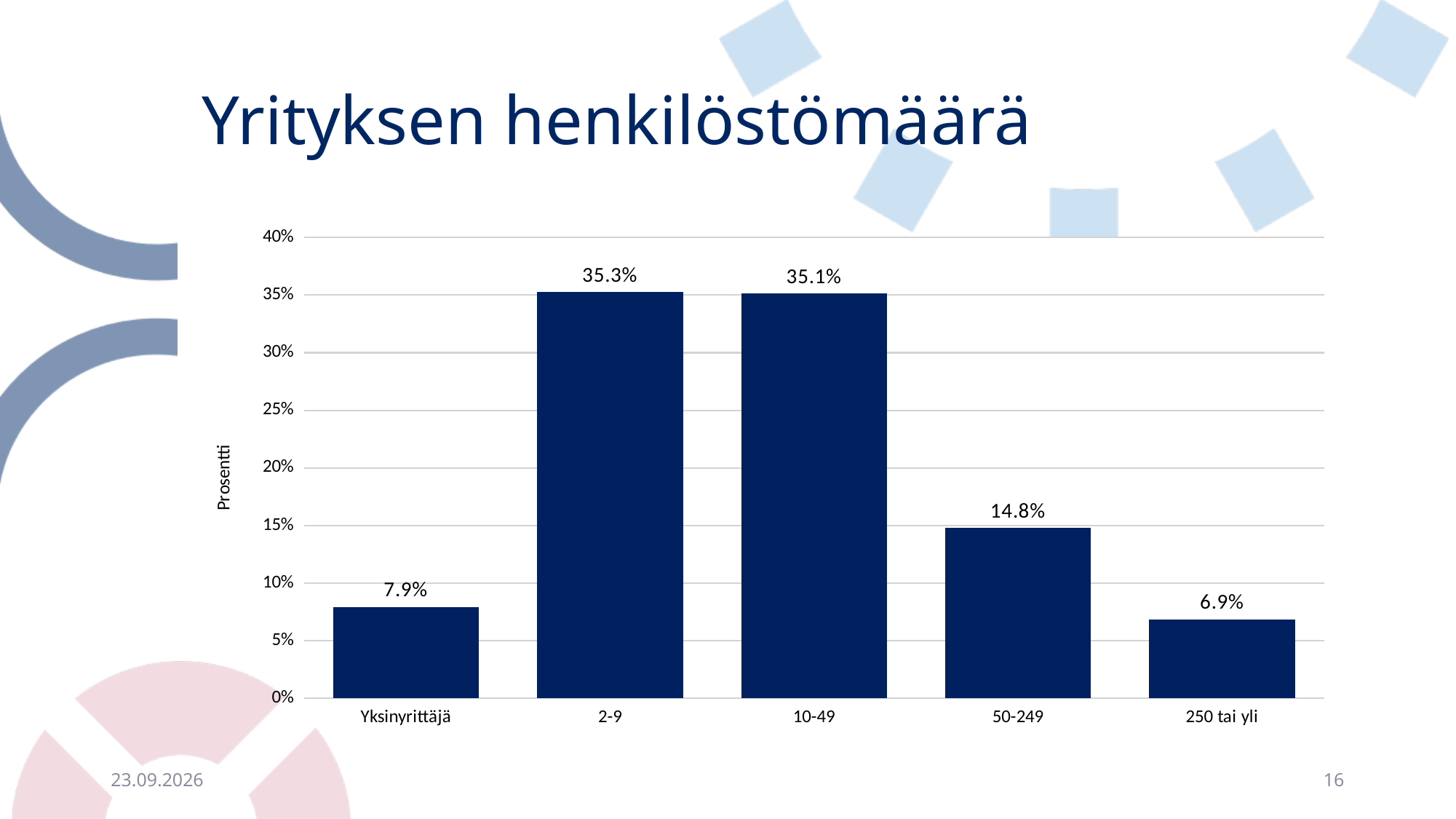
How many categories are shown on the x axis? 5 What is the difference between the values for 50-249 and 250 tai yli? 7.9% What is the difference between the values for 2-9 and 10-49? 0.2% What is the value for Yksinyrittäjä? 7.9% What is the value for the 250 tai yli category? 6.9% Is the value for 10-49 greater or less than 30%? greater Which category has the lowest value? 250 tai yli Which is larger, the value for Yksinyrittäjä or the value for 50-249? 50-249 What is the label of the y axis? Prosentti What is the value for the 2-9 category? 35.3% What is the value for the 50-249 category? 14.8% What kind of chart is shown on the slide? bar chart